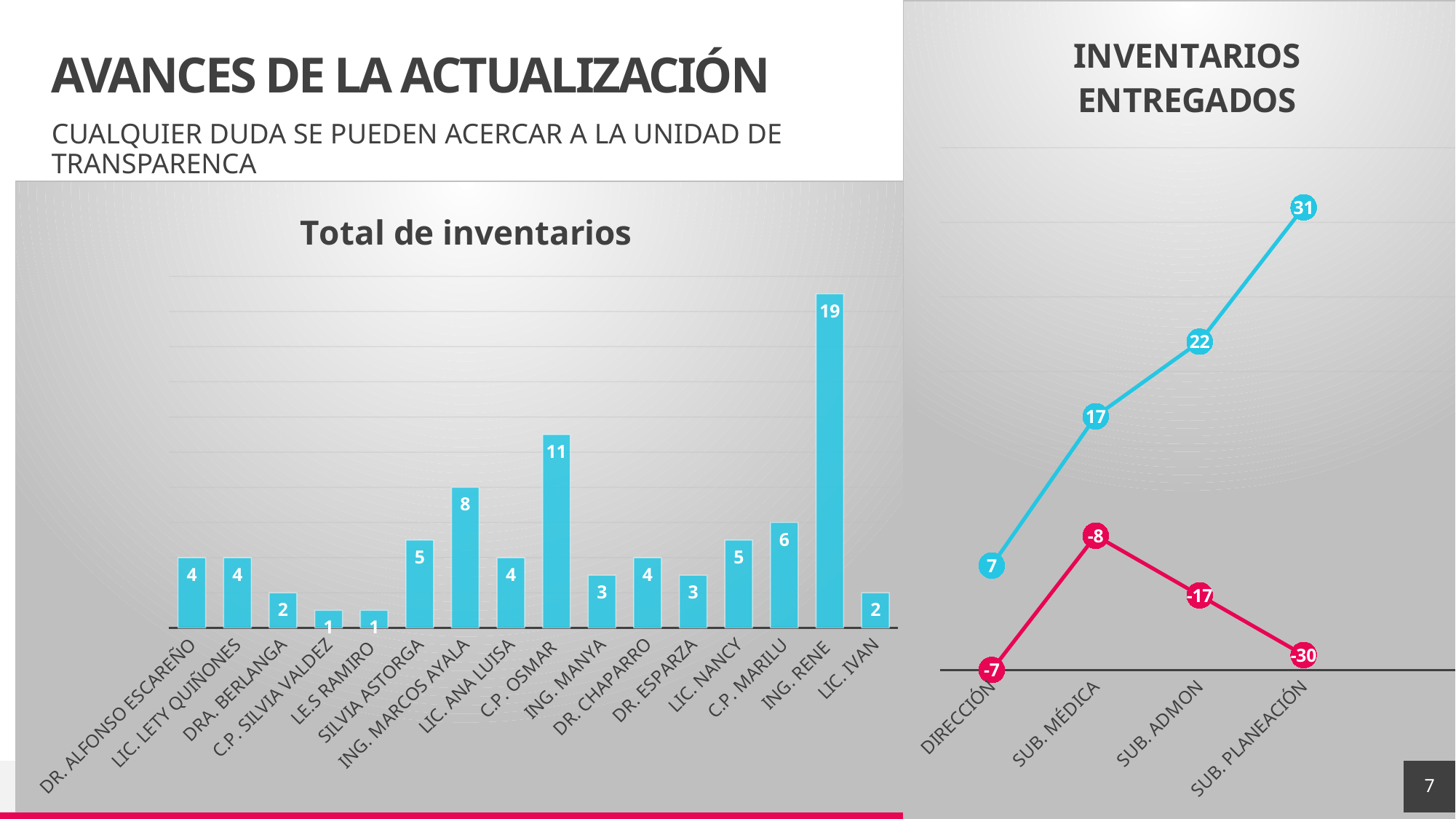
What kind of chart is 'Total de inventarios'? bar chart In the 'Total de inventarios' chart, what is the value for C.P. OSMAR? 11 In the 'Total de inventarios' chart, what is the value for ING. RENE? 19 In the 'INVENTARIOS ENTREGADOS' chart, does the blue line rise or fall from DIRECCIÓN to SUB. PLANEACIÓN? rise In the 'Total de inventarios' chart, which is larger, ING. MARCOS AYALA or C.P. MARILU? ING. MARCOS AYALA How many categories are shown in the 'Total de inventarios' chart? 16 In the 'INVENTARIOS ENTREGADOS' chart, what is the value of the blue line at SUB. PLANEACIÓN? 31 How many categories are on the x axis of the 'INVENTARIOS ENTREGADOS' chart? 4 What kind of chart is 'INVENTARIOS ENTREGADOS'? line chart In the 'Total de inventarios' chart, which category has the highest value? ING. RENE In the 'INVENTARIOS ENTREGADOS' chart, what is the value of the red line at SUB. ADMON? -17 In the 'Total de inventarios' chart, what is the difference between ING. RENE and C.P. OSMAR? 8